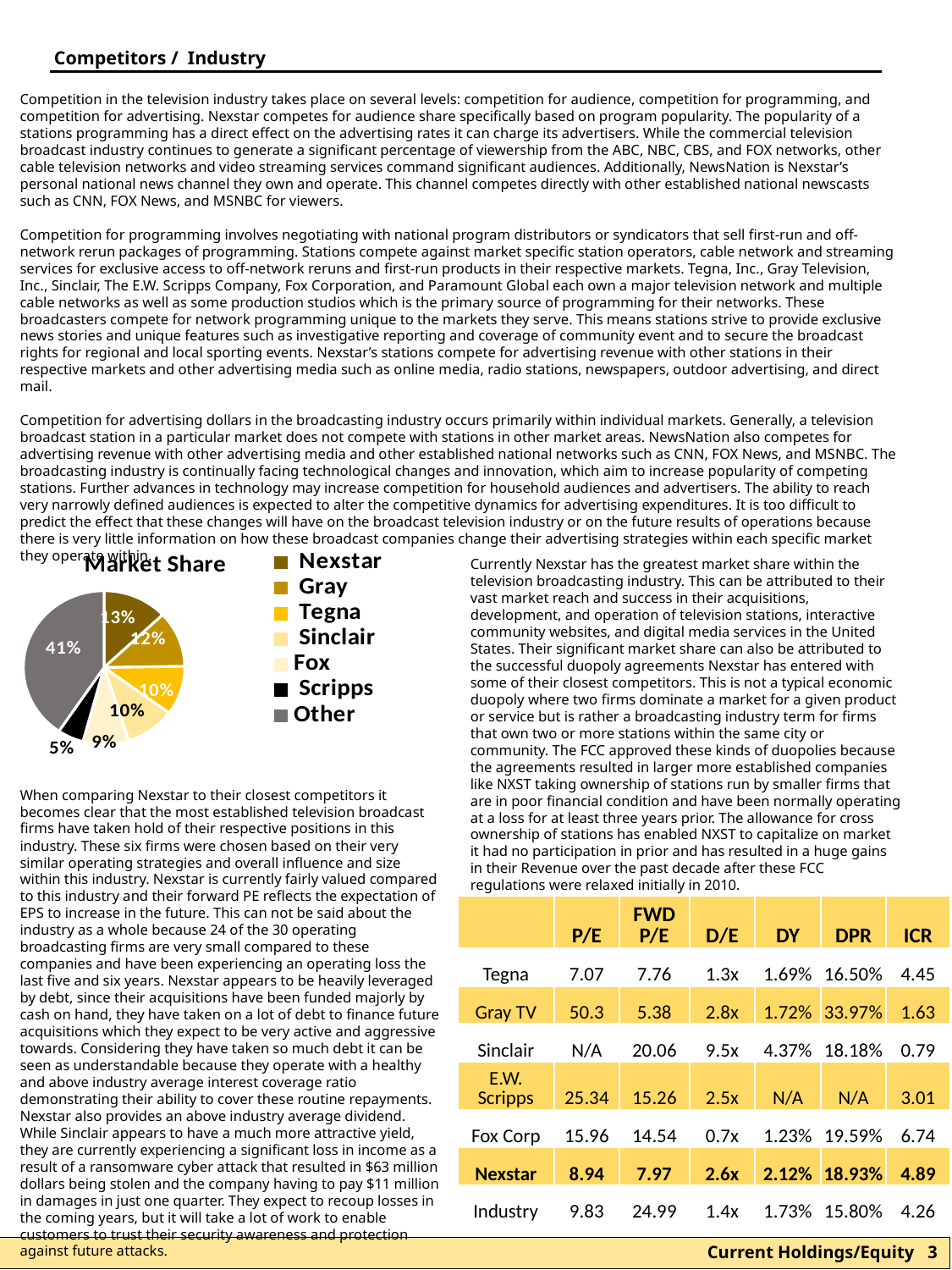
What is the value shown for Fox in the Market Share pie chart? 9% What is the value shown for Gray in the Market Share pie chart? 12% What is the title of the pie chart? Market Share Which category has the smallest slice in the Market Share pie chart? Scripps How many slices does the Market Share pie chart have? 7 What type of chart is the Market Share chart? pie chart Which category has the largest slice in the Market Share pie chart? Other What is the value shown for Scripps in the Market Share pie chart? 5% How many entries does the legend of the Market Share pie chart list? 7 In the Market Share pie chart, which is larger, the Gray slice or the Fox slice? Gray In the Market Share pie chart, what is the difference between the Other slice and the Nexstar slice? 28% What share of the Market Share pie does Nexstar hold? 13%